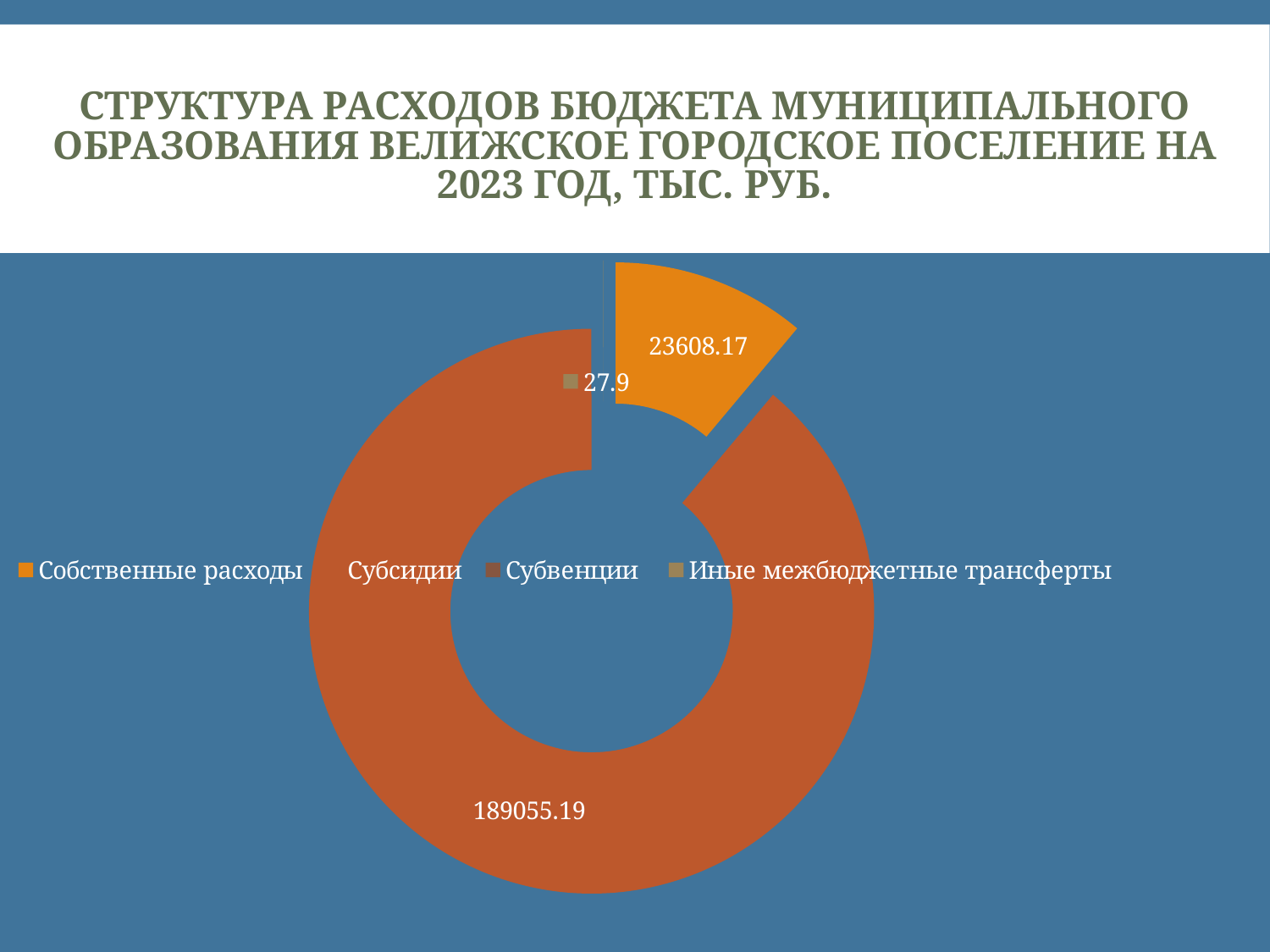
What value is shown for the Иные межбюджетные трансферты segment? 27.9 How many categories does the legend list? 4 Which year does the chart title refer to? 2023 Which labelled category has the smallest value in the chart? Иные межбюджетные трансферты What value is shown for the Собственные расходы segment? 23608.17 How many data labels are printed on the chart? 3 What unit of measurement is stated in the slide title? тыс. руб. Which category has the largest value in the chart? Субсидии What type of chart is shown on the slide? Doughnut (pie) chart